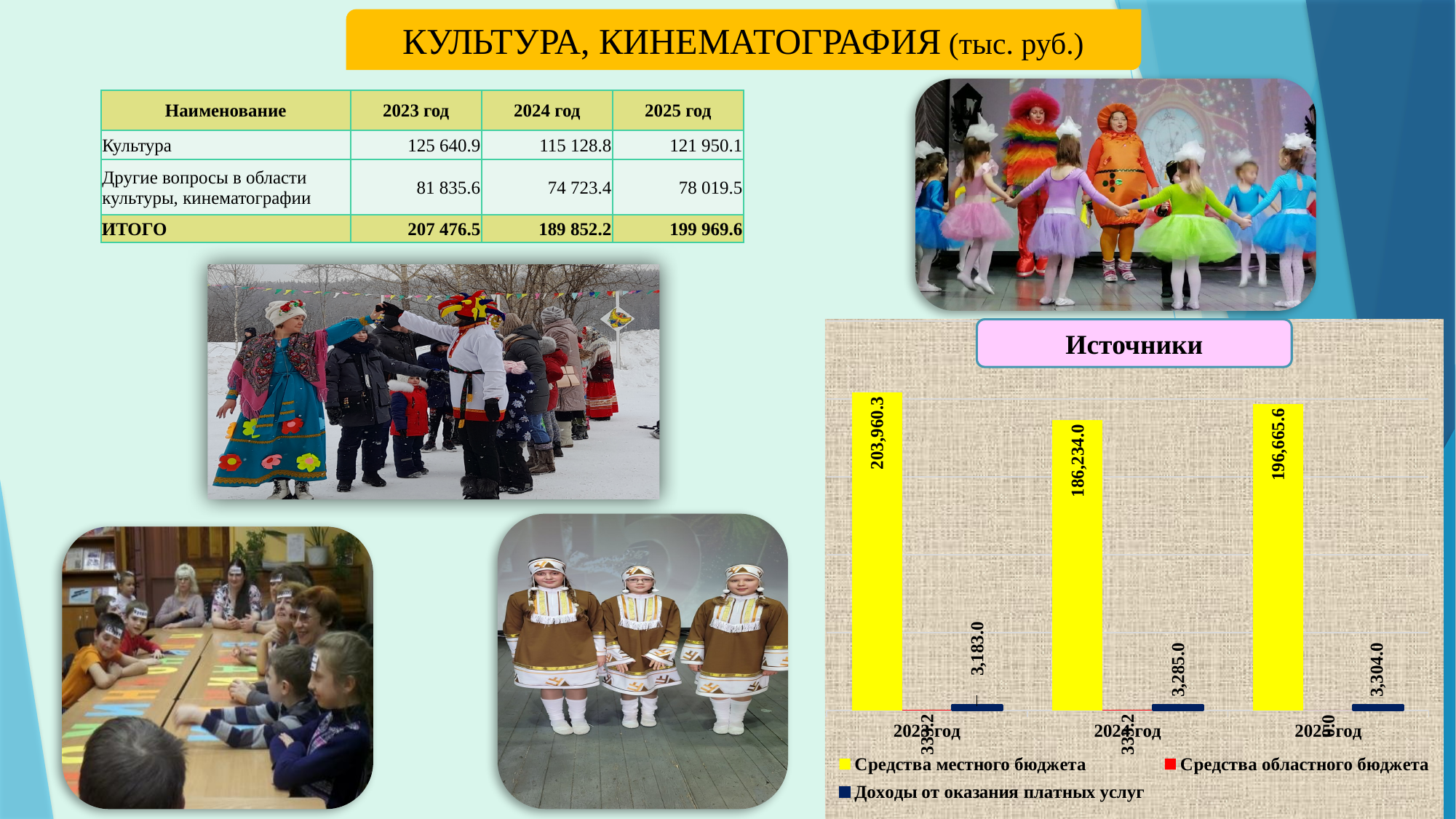
In the "Источники" chart, what is the difference between Средства местного бюджета in 2023 год and 2024 год? 17,726.3 How many year categories are shown on the x axis of the "Источники" chart? 3 How many series does the legend of the "Источники" chart list? 3 In the "Источники" chart, do the values for Доходы от оказания платных услуг rise or fall from 2023 год to 2025 год? rise In the "Источники" chart, what is the value of Средства местного бюджета for 2025 год? 196,665.6 In the "Источники" chart, what is the value of Доходы от оказания платных услуг for 2025 год? 3,304.0 In the "Источники" chart, what is the value of Доходы от оказания платных услуг for 2023 год? 3,183.0 In the "Источники" chart, what is the value of Средства местного бюджета for 2024 год? 186,234.0 In the "Источники" chart, which year has the lowest value for Средства местного бюджета? 2024 год In the "Источники" chart, what is the value of Средства местного бюджета for 2023 год? 203,960.3 In the "Источники" chart, which year has the highest value for Средства местного бюджета? 2023 год What kind of chart is the "Источники" chart? bar chart